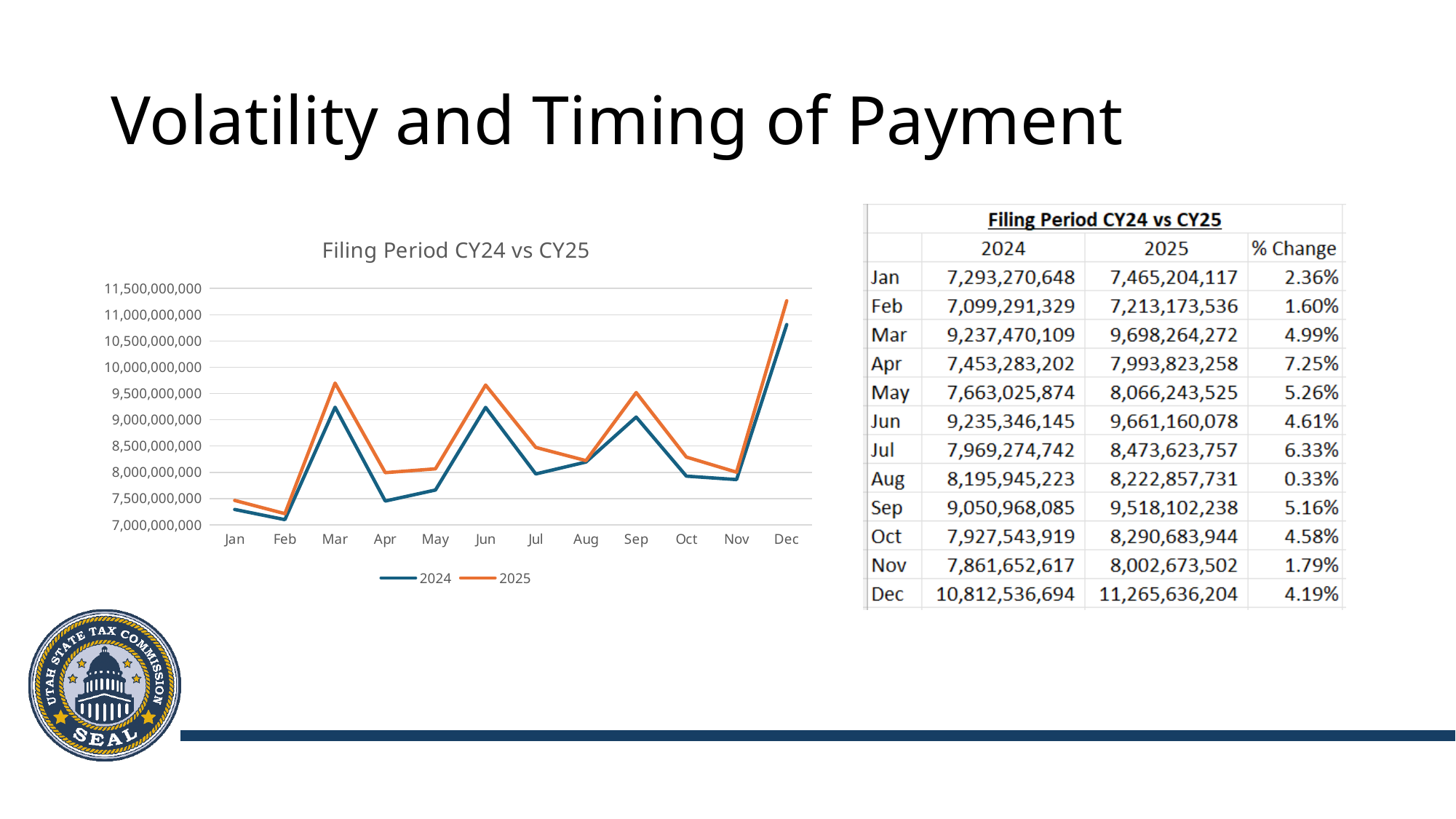
According to the table on the slide, what is the 2025 value for Jul? 8,473,623,757 Do the values for the 2024 series rise or fall from Oct to Nov? fall Which is larger in Sep, the 2024 value or the 2025 value? 2025 Is the 2024 value for Apr greater or less than 7,500,000,000? less How many series does the chart legend list? 2 Which month has the highest value for the 2025 series? Dec According to the table on the slide, what is the % Change for Apr? 7.25% What kind of chart is shown on the slide? line chart Is the 2025 value for Mar greater or less than 9,500,000,000? greater How many months are plotted along the x axis of the chart? 12 Which month has the lowest value for the 2024 series? Feb What is the title of the chart? Filing Period CY24 vs CY25